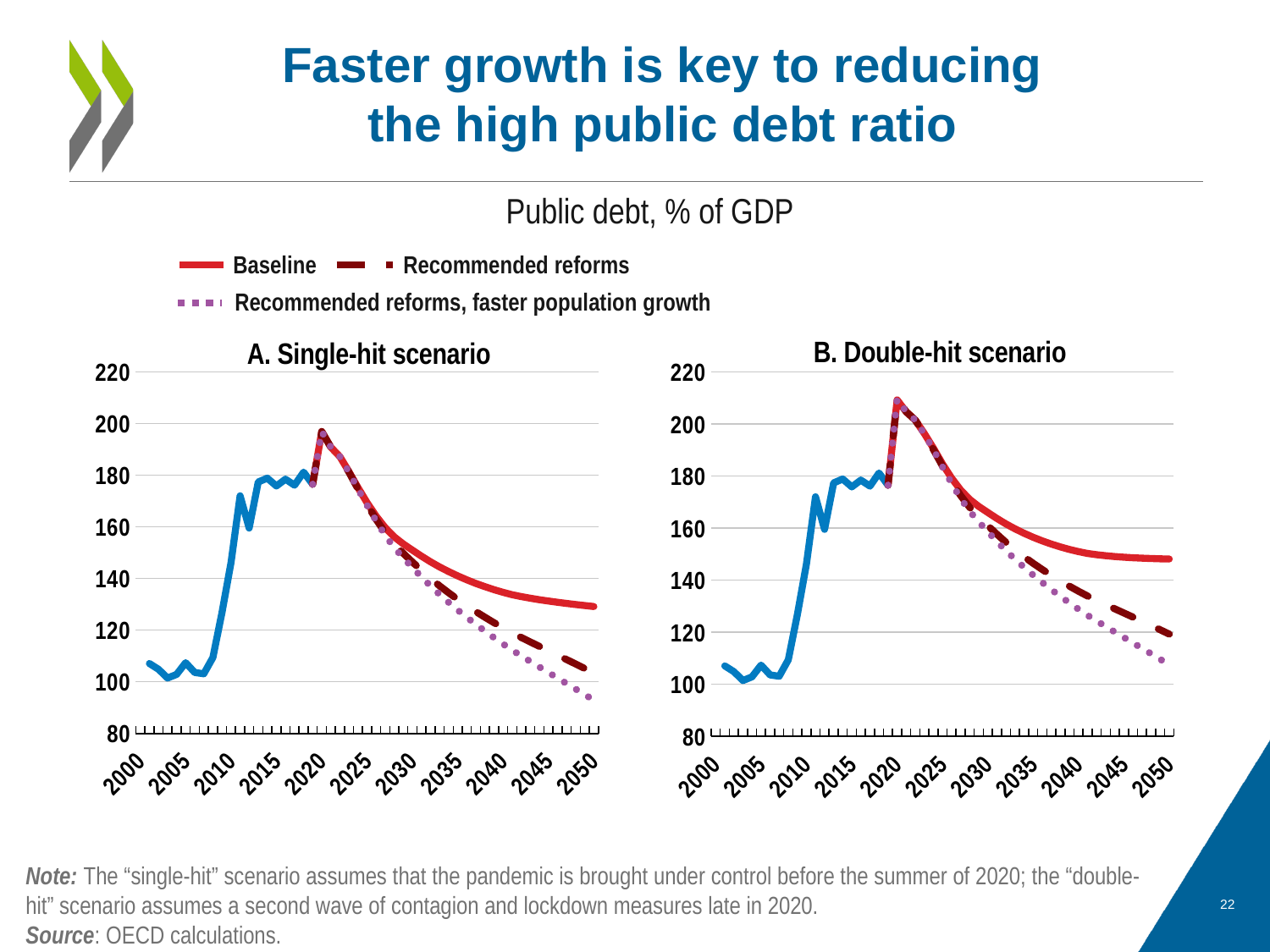
In the A. Single-hit scenario chart, is the Baseline value in 2050 greater or less than 140? less Which chart shows the higher Baseline value in 2050, A. Single-hit scenario or B. Double-hit scenario? B. Double-hit scenario In the A. Single-hit scenario chart, is the peak value of public debt greater or less than 200? less How many series does the legend list for the charts? 3 In the A. Single-hit scenario chart, is the value for Recommended reforms, faster population growth in 2050 greater or less than 100? less What kind of chart is the A. Single-hit scenario chart? line chart What is the common subtitle describing the measure plotted in both charts? Public debt, % of GDP In the B. Double-hit scenario chart, which series has the higher value in 2050, Baseline or Recommended reforms? Baseline In the B. Double-hit scenario chart, does the Baseline series rise or fall between 2020 and 2050? fall